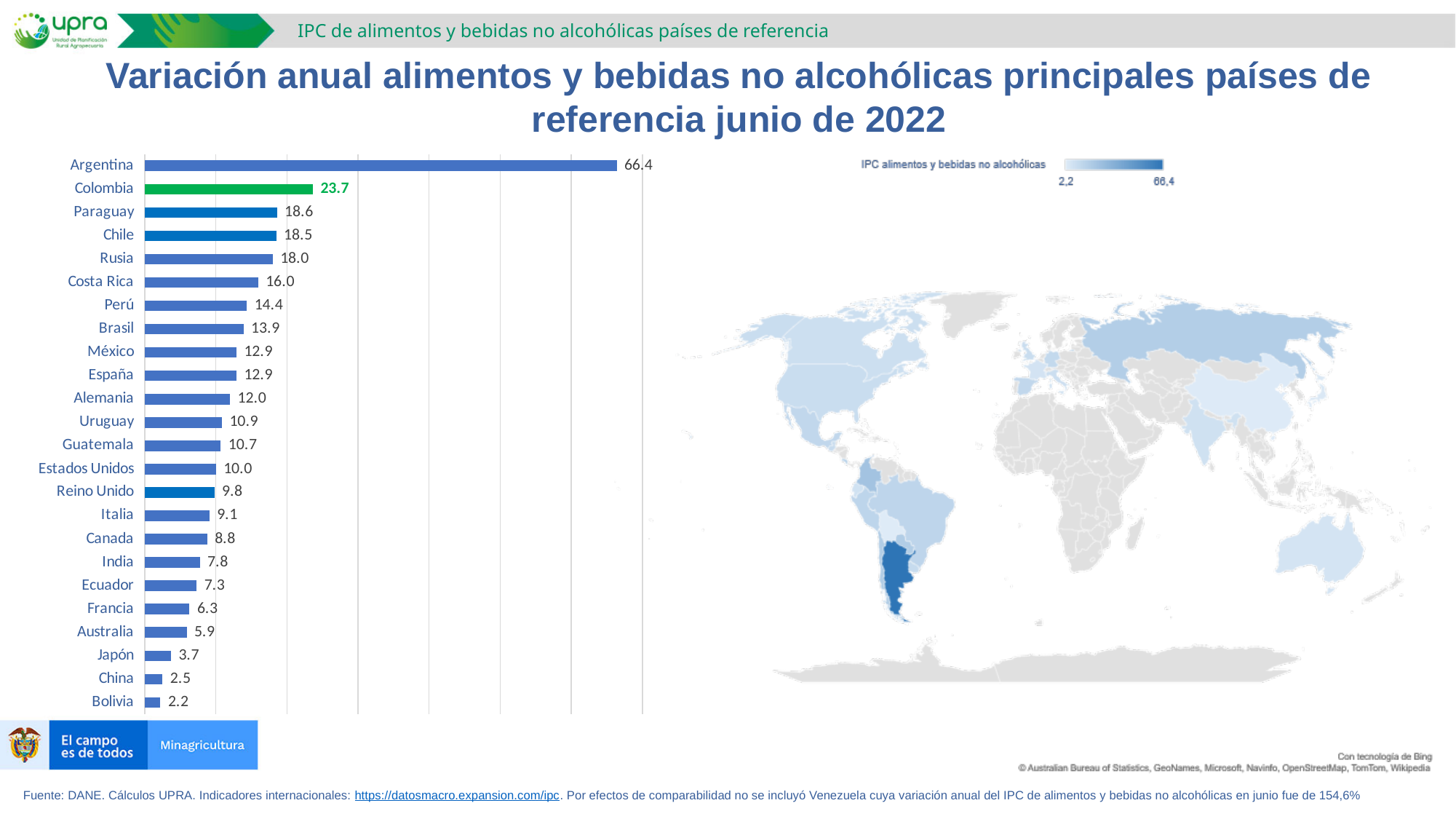
In the bar chart on the left, which country's bar is coloured green instead of blue? Colombia In the bar chart on the left, which has a larger value, Brasil or Perú? Perú In the bar chart on the left, what is the difference between the values for Argentina and Colombia? 42.7 In the bar chart on the left, what is the difference between the values for Paraguay and Chile? 0.1 In the bar chart on the left, what is the value for Colombia? 23.7 In the bar chart on the left, which country has the lowest value? Bolivia How many countries are shown in the bar chart on the left? 24 In the bar chart on the left, what is the value for Rusia? 18.0 In the bar chart on the left, what is the value for Estados Unidos? 10.0 In the bar chart on the left, which has a larger value, Japón or Australia? Australia What kind of chart is shown on the left of the slide? Bar chart In the bar chart on the left, which country has the highest value? Argentina